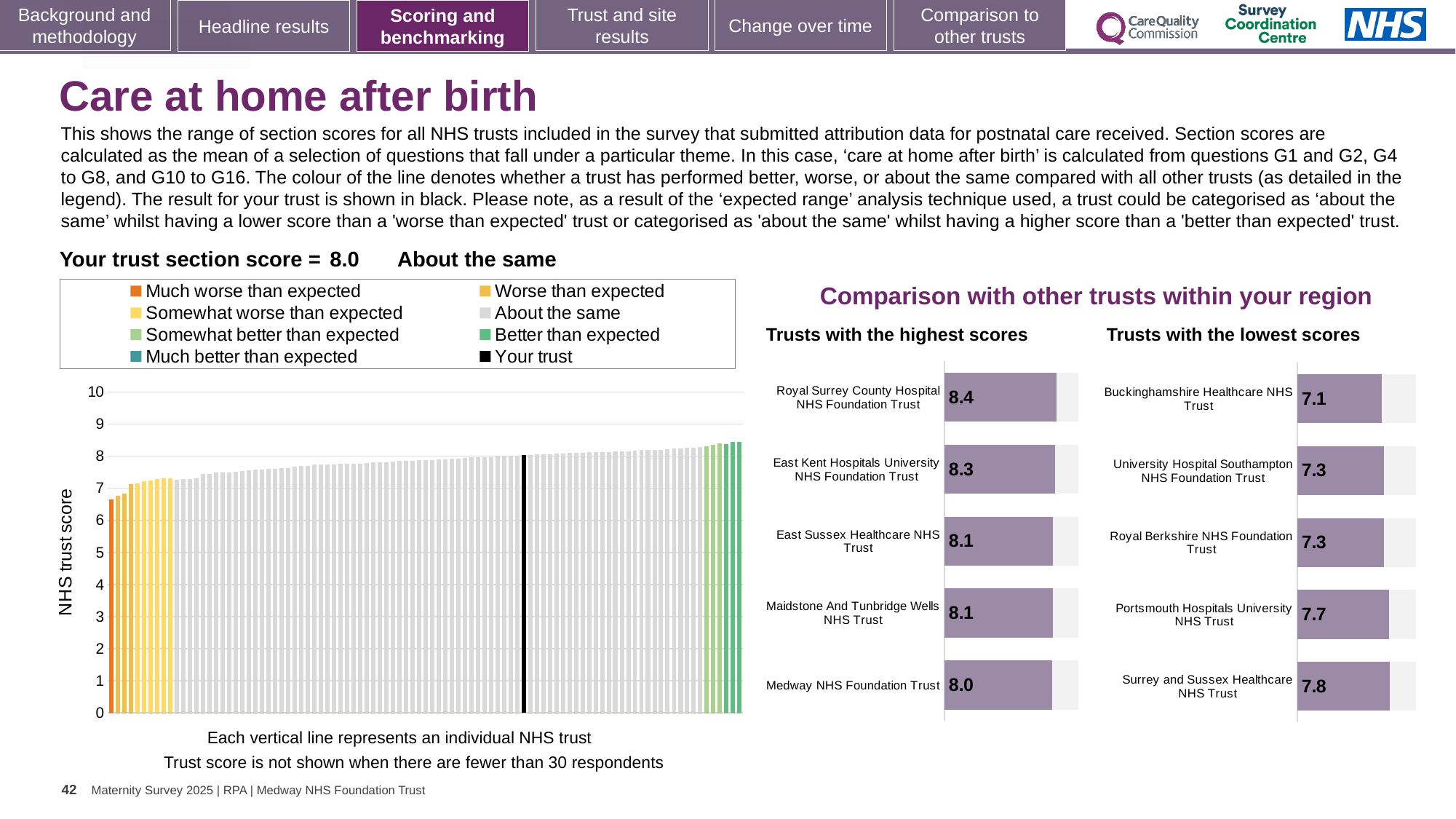
In the 'Trusts with the lowest scores' chart, which trust has the lowest score? Buckinghamshire Healthcare NHS Trust How many trusts are shown in the 'Trusts with the highest scores' chart? 5 How many entries does the legend above the left-hand NHS trust score chart list? 8 In the 'Trusts with the highest scores' chart, what is the difference between the scores of Royal Surrey County Hospital NHS Foundation Trust and Medway NHS Foundation Trust? 0.4 What is the y-axis label of the left-hand chart? NHS trust score In the 'Trusts with the highest scores' chart, what is the score for Royal Surrey County Hospital NHS Foundation Trust? 8.4 In the 'Trusts with the highest scores' chart, what is the score for Medway NHS Foundation Trust? 8.0 In the 'Trusts with the lowest scores' chart, what is the difference between the scores of Surrey and Sussex Healthcare NHS Trust and Buckinghamshire Healthcare NHS Trust? 0.7 What kind of chart is the large chart on the left showing NHS trust scores? bar chart In the 'Trusts with the highest scores' chart, which trust has the highest score? Royal Surrey County Hospital NHS Foundation Trust In the 'Trusts with the lowest scores' chart, which has the larger score: Portsmouth Hospitals University NHS Trust or Surrey and Sussex Healthcare NHS Trust? Surrey and Sussex Healthcare NHS Trust In the 'Trusts with the lowest scores' chart, what is the score for Buckinghamshire Healthcare NHS Trust? 7.1